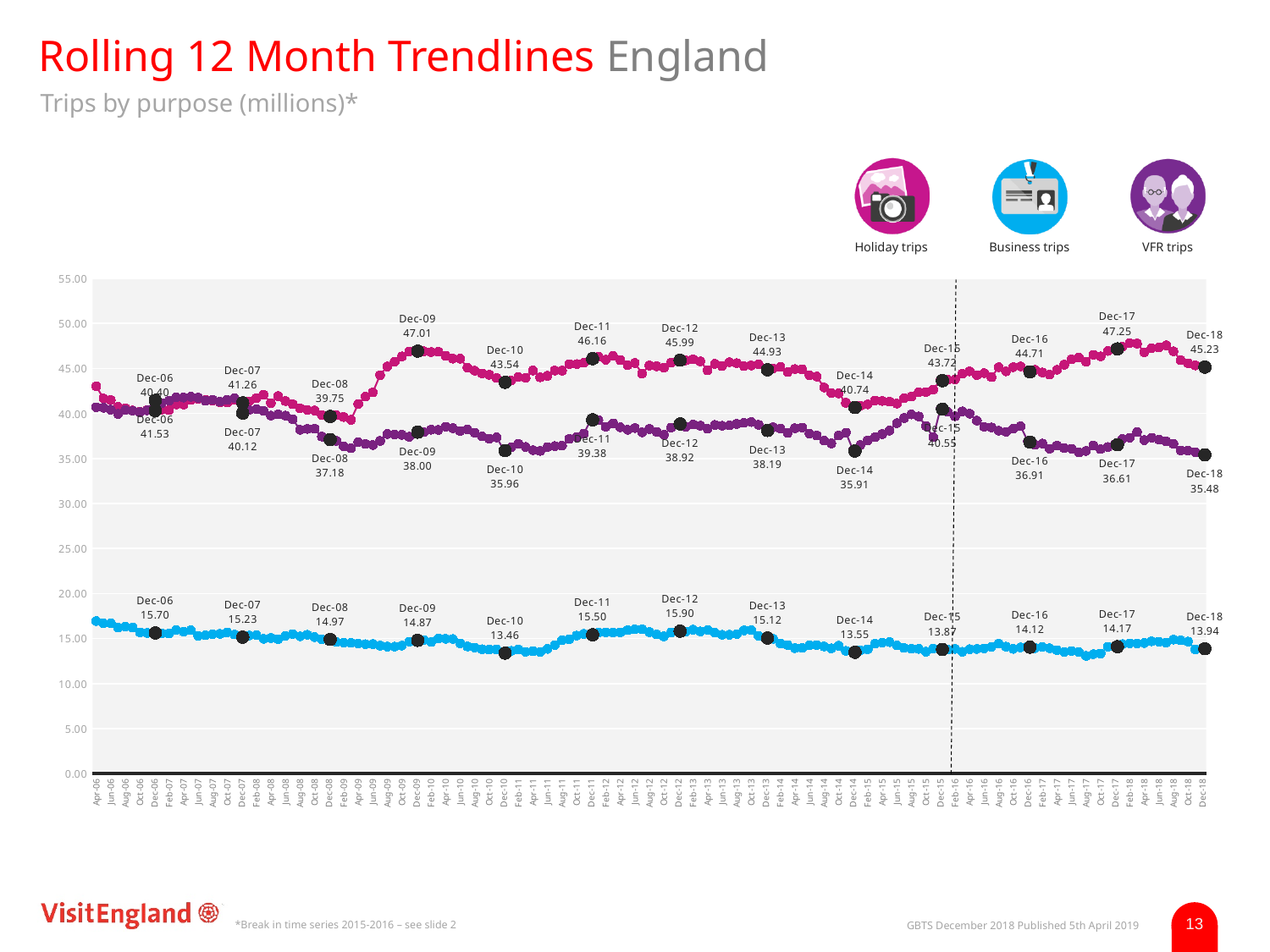
Do Business trips rise or fall overall from Dec-06 to Dec-18? fall What is the difference between Holiday trips and VFR trips at Dec-18? 9.75 Which is larger for Holiday trips: the Dec-09 value or the Dec-11 value? Dec-09 What is the value for Business trips at Dec-12? 15.90 Is the value for Business trips at Dec-18 greater or less than 15.00? less What is the value for Holiday trips at Dec-18? 45.23 Among the labelled December points for Holiday trips, which has the highest value? Dec-17 How many series does the chart show? 3 What kind of chart is shown on the slide? line chart Among the labelled December points for VFR trips, which has the lowest value? Dec-18 What is the value for VFR trips at Dec-10? 35.96 Among the labelled December points for Business trips, which has the lowest value? Dec-10